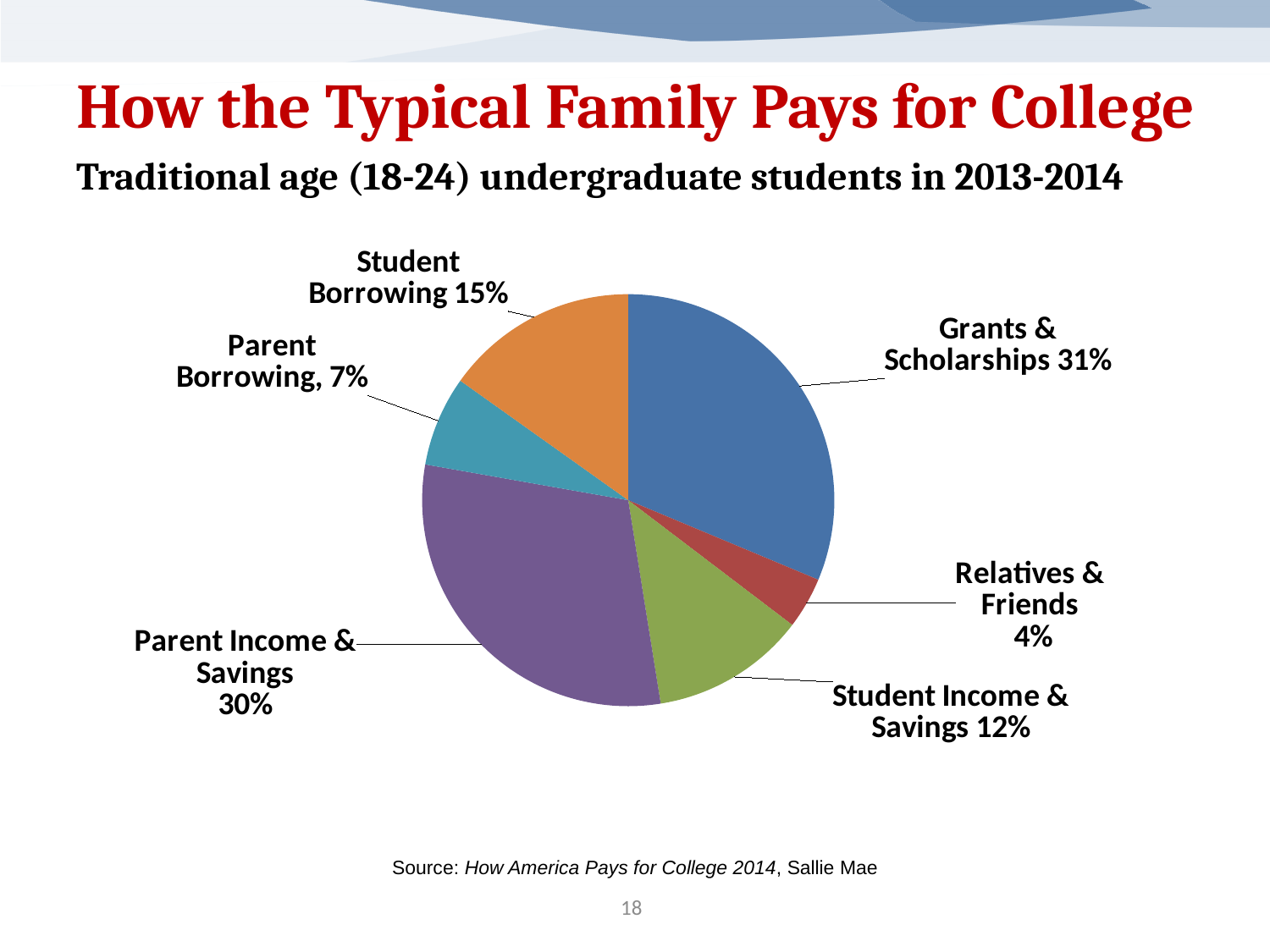
What share of college costs comes from Relatives & Friends? 4% Which source has the smallest share of the pie? Relatives & Friends What share of college costs comes from Parent Income & Savings? 30% How many slices does the pie chart have? 6 Which source has the largest share of the pie? Grants & Scholarships What share of college costs comes from Student Borrowing? 15% Which is larger, Student Income & Savings or Parent Borrowing? Student Income & Savings What kind of chart is shown on the slide? pie chart What is the title of the chart on the slide? How the Typical Family Pays for College What is the difference in percentage points between Student Borrowing and Parent Borrowing? 8 What share of college costs comes from Grants & Scholarships? 31% What share of college costs comes from Parent Borrowing? 7%